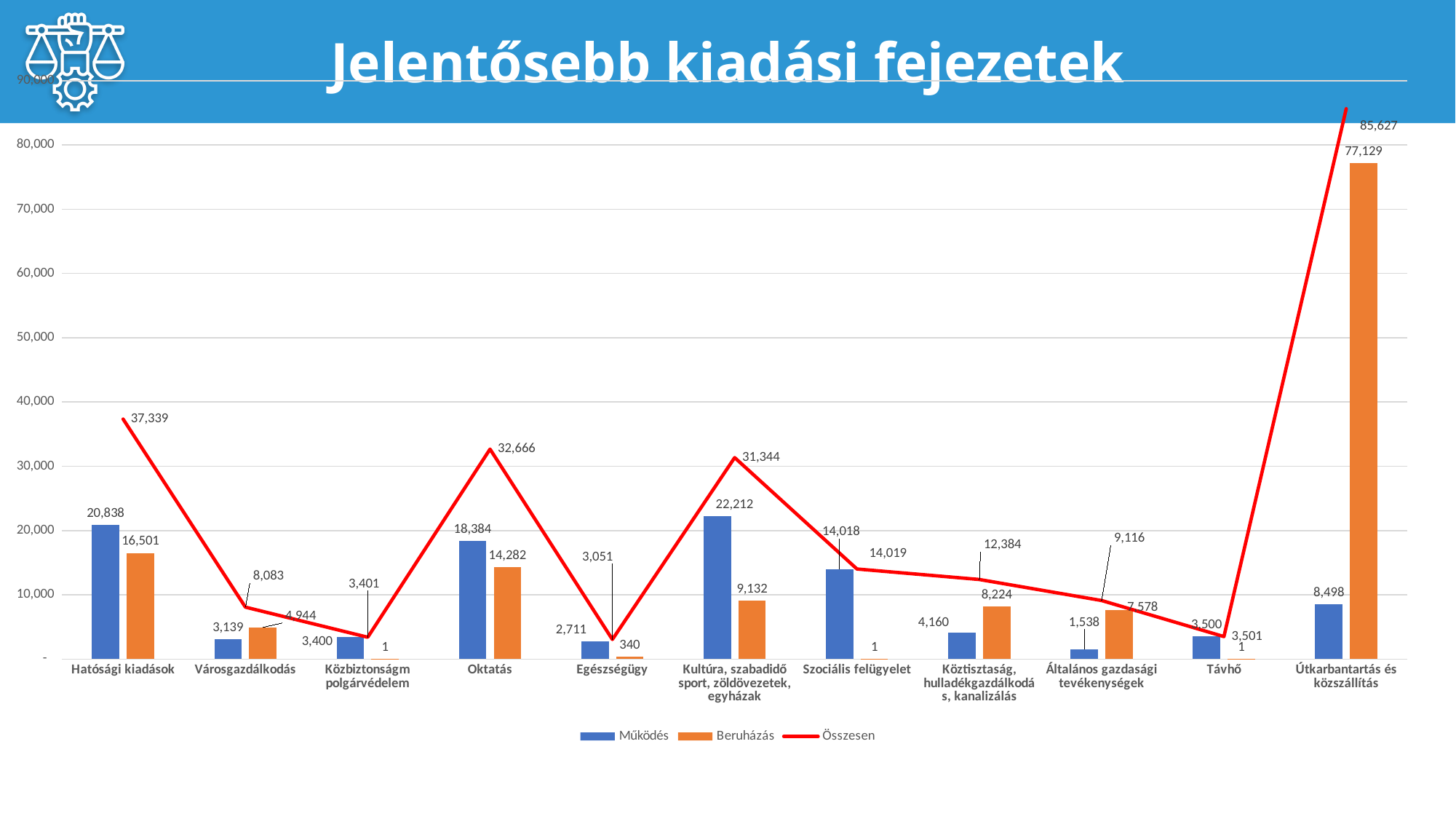
What is the Működés value for Oktatás? 18,384 What is the Összesen value for Hatósági kiadások? 37,339 Is the Beruházás value for Útkarbantartás és közszállítás greater or less than 70,000? greater What kind of chart is this? Combined bar and line chart What is the Beruházás value for Útkarbantartás és közszállítás? 77,129 What is the difference between the Működés and Beruházás values for Hatósági kiadások? 4,337 Which category has the lowest Működés value? Általános gazdasági tevékenységek How many categories are shown on the x axis? 11 How many series does the legend list? 3 Which category has the highest Összesen value? Útkarbantartás és közszállítás What is the title of the chart? Jelentősebb kiadási fejezetek Which is larger for Köztisztaság, hulladékgazdálkodás, kanalizálás: Működés or Beruházás? Beruházás